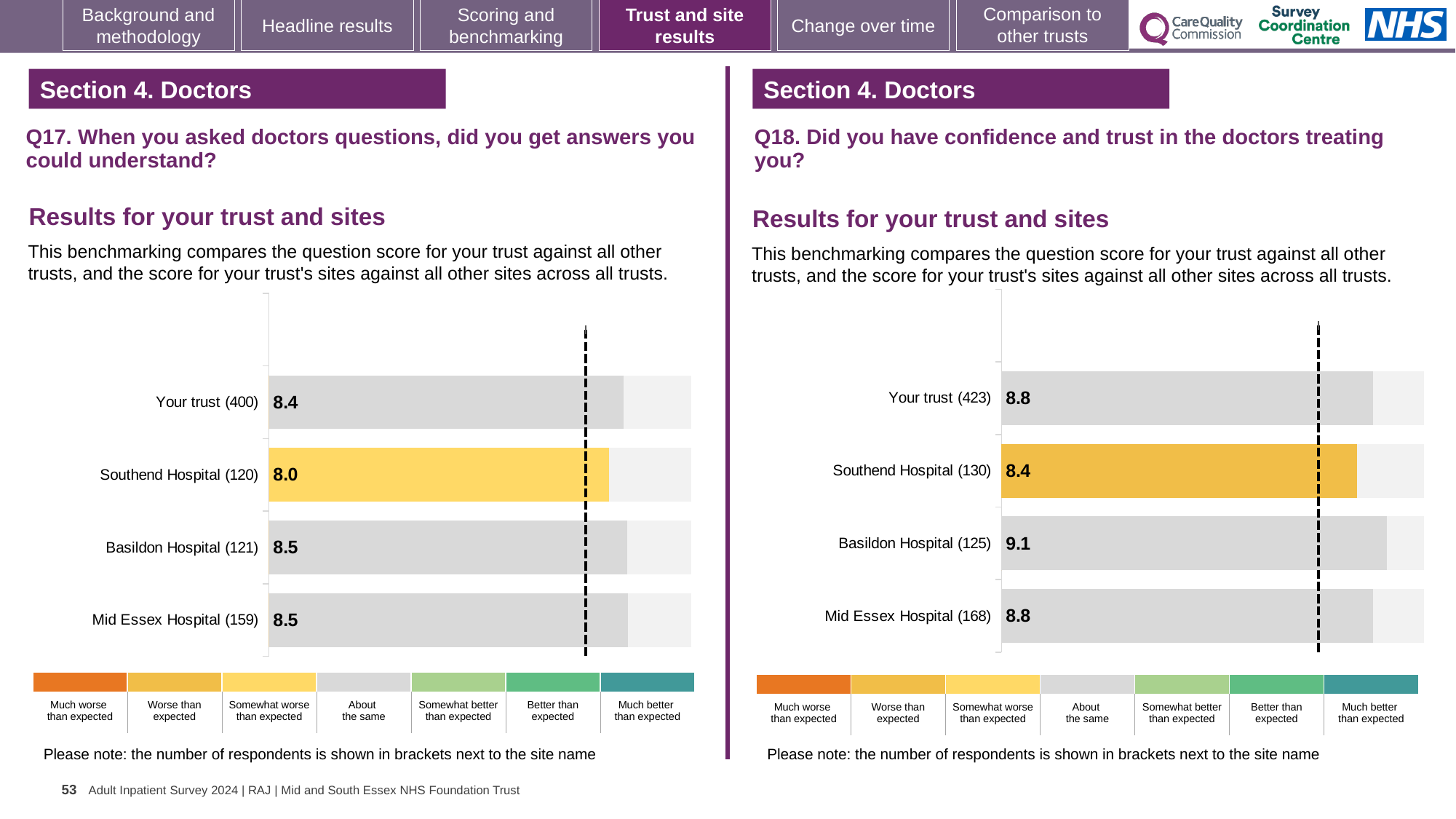
What kind of chart is used on the Q17 chart (left)? Bar chart On the Q17 chart (left), what is the difference between the Basildon Hospital score and the Southend Hospital score? 0.5 On the Q18 chart (right), what is the difference between the Basildon Hospital score and the Southend Hospital score? 0.7 On the Q18 chart (right), what is the score for Basildon Hospital? 9.1 On the Q18 chart (right), which is larger, the score for Your trust or the score for Southend Hospital? Your trust On the Q18 chart (right), how many respondents are shown in brackets for Your trust? 423 On the Q17 chart (left), how many bars are plotted? 4 On the Q18 chart (right), what is the score for Mid Essex Hospital? 8.8 On the Q17 chart (left), which site has the lowest score? Southend Hospital On the Q17 chart (left), what is the score for Your trust? 8.4 On the Q18 chart (right), which site has the highest score? Basildon Hospital On the Q17 chart (left), what is the score for Southend Hospital? 8.0